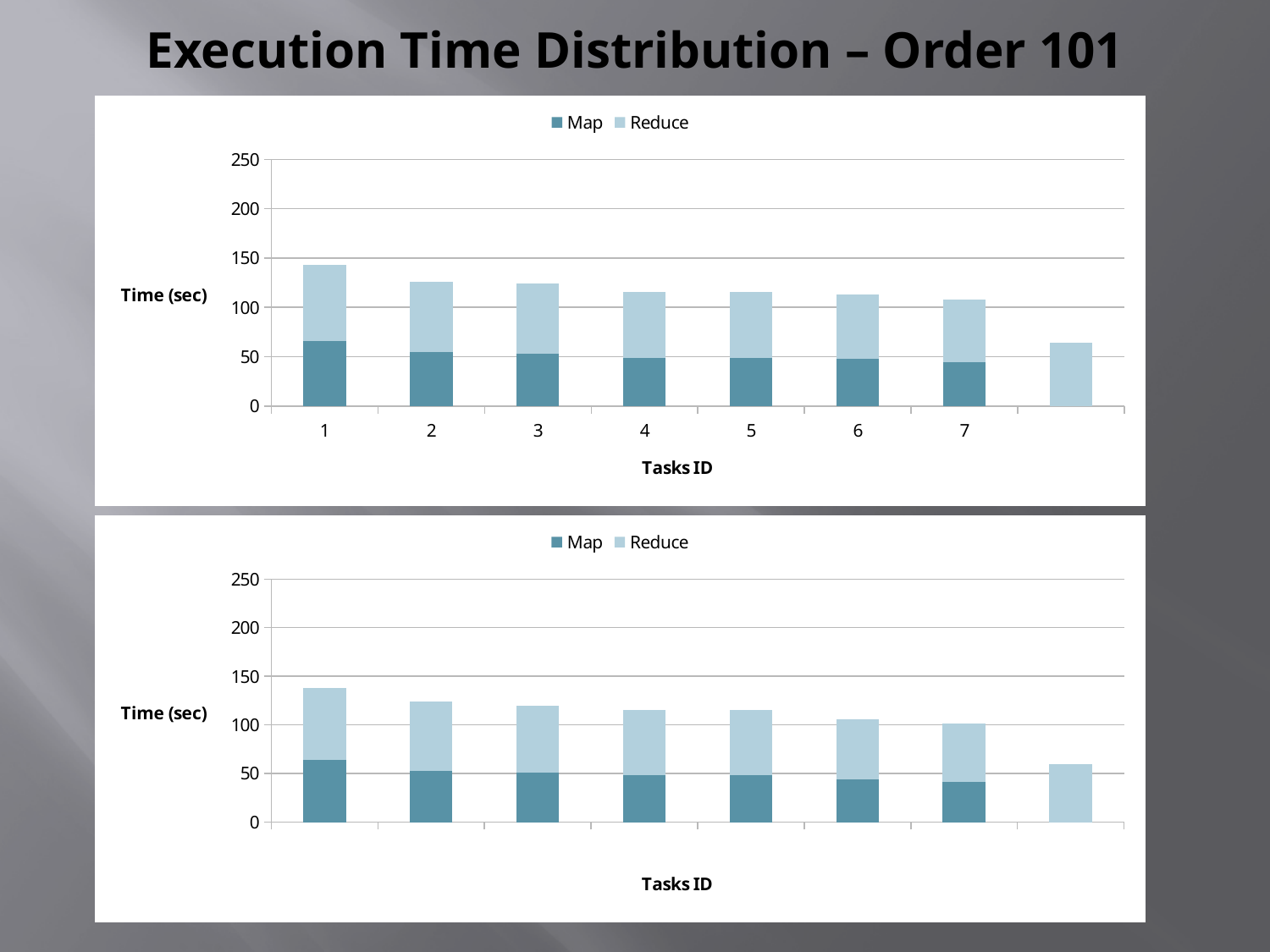
In the top chart, is the total execution time for task 1 greater or less than 100? greater What kind of chart is the top chart on the slide? stacked bar chart In the top chart, do the total execution times rise or fall from task 1 to task 7? fall In the top chart, how many task IDs are labeled on the x axis? 7 In the top chart, which labeled task ID has the lowest total execution time? 7 In the top chart, which labeled task ID has the highest total execution time? 1 In the top chart, which has the larger total execution time, task 1 or task 7? task 1 How many series does the legend of the top chart list? 2 In the bottom chart, is the total height of the first bar greater or less than 100? greater In the top chart, is the Map time for task 1 greater or less than 50? greater What are the two series named in the legend of the bottom chart? Map and Reduce